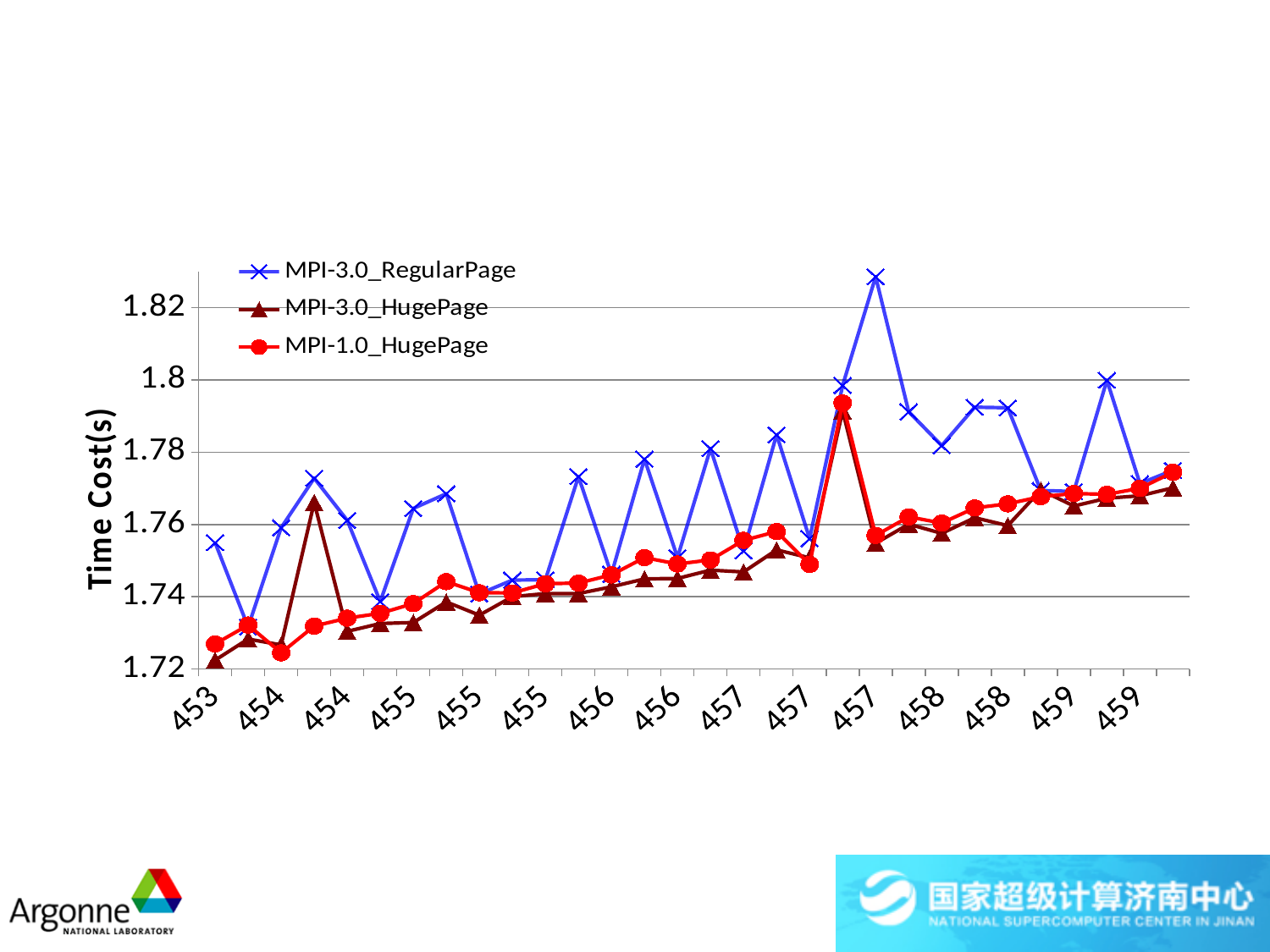
Do the MPI-1.0_HugePage values generally rise or fall from left to right along the x axis? rise Is the first value of the MPI-3.0_HugePage series (at 453) greater or less than 1.74? less Is the value of MPI-3.0_RegularPage at the first x-axis point (453) greater or less than 1.74? greater What kind of chart is shown on the slide? line chart Which series has the highest value at the first x-axis point (453)? MPI-3.0_RegularPage Is the peak value of the MPI-1.0_HugePage series near 457 greater or less than 1.78? greater Which series is drawn with blue x markers according to the legend? MPI-3.0_RegularPage What is the title of the vertical axis? Time Cost(s) How many series does the legend list? 3 Which series generally has the highest time cost across the x axis? MPI-3.0_RegularPage